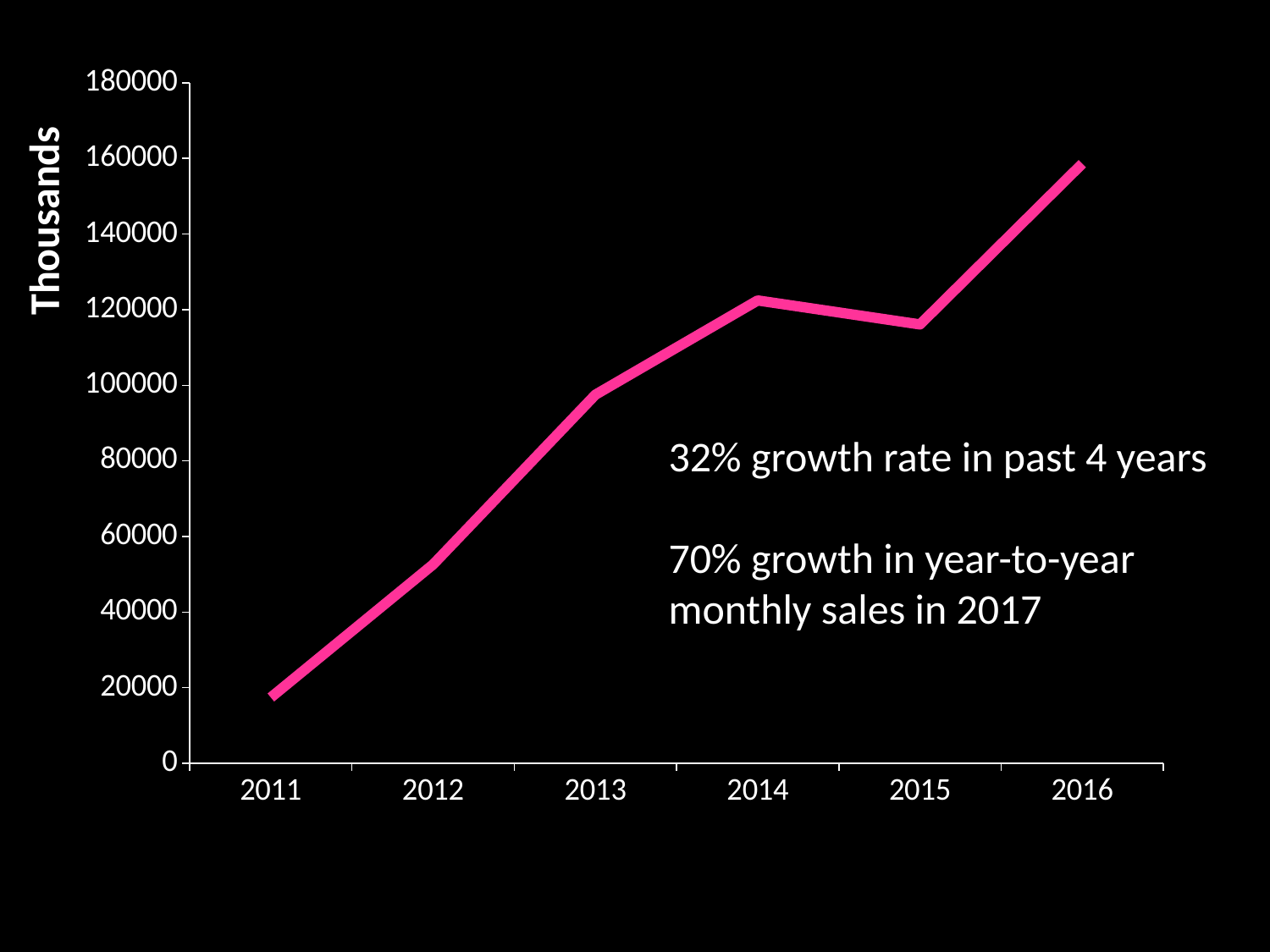
Which is larger, the value for 2013 or the value for 2015? 2015 Is the value for 2014 greater or less than 120000? greater Is the value for 2011 greater or less than 20000? less What is the label on the y axis? Thousands Do the values generally rise or fall from 2011 to 2016? rise Which year has the highest value? 2016 Which is larger, the value for 2012 or the value for 2014? 2014 Which year has the lowest value? 2011 What kind of chart is shown on the slide? line chart Is the value for 2016 greater or less than 140000? greater How many years are plotted on the x axis? 6